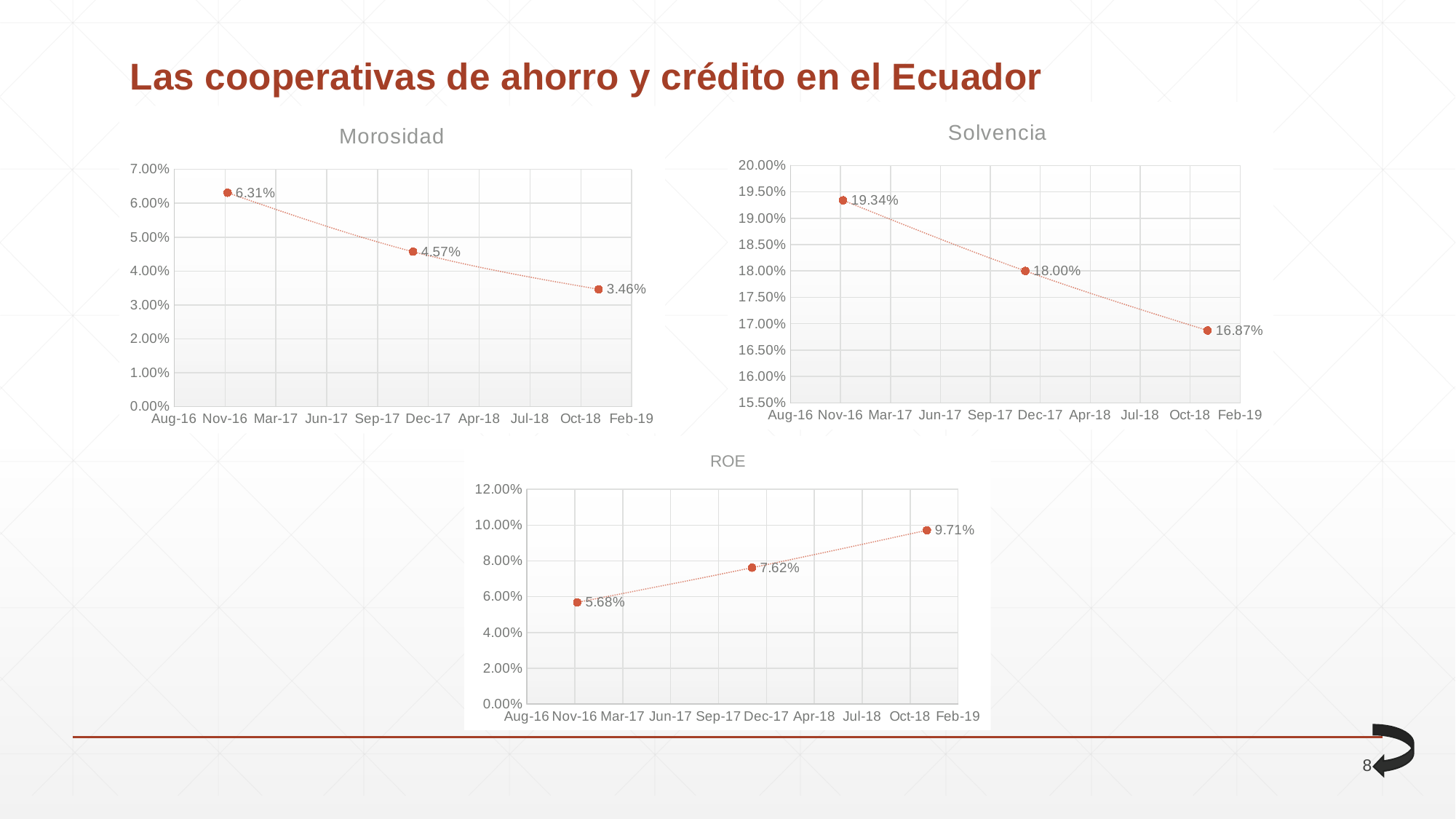
In the Solvencia chart, what is the difference between the first value (19.34%) and the last value (16.87%)? 2.47% In the Solvencia chart, which data point has the lowest value? The last data point (16.87%) In the Solvencia chart, what is the value of the middle data point (Dec-17)? 18.00% In the Morosidad chart, what is the value of the last data point (Oct-18)? 3.46% How many data points are plotted in the Morosidad chart? 3 In the Morosidad chart, do the values rise or fall over time? fall What type of chart is the ROE chart? line chart In the Morosidad chart, what is the value of the first data point (Nov-16)? 6.31% In the ROE chart, what is the value of the last data point (Oct-18)? 9.71% In the ROE chart, what is the difference between the last value (9.71%) and the first value (5.68%)? 4.03% In the ROE chart, which data point has the highest value? The last data point (9.71%) In the ROE chart, do the values rise or fall over time? rise